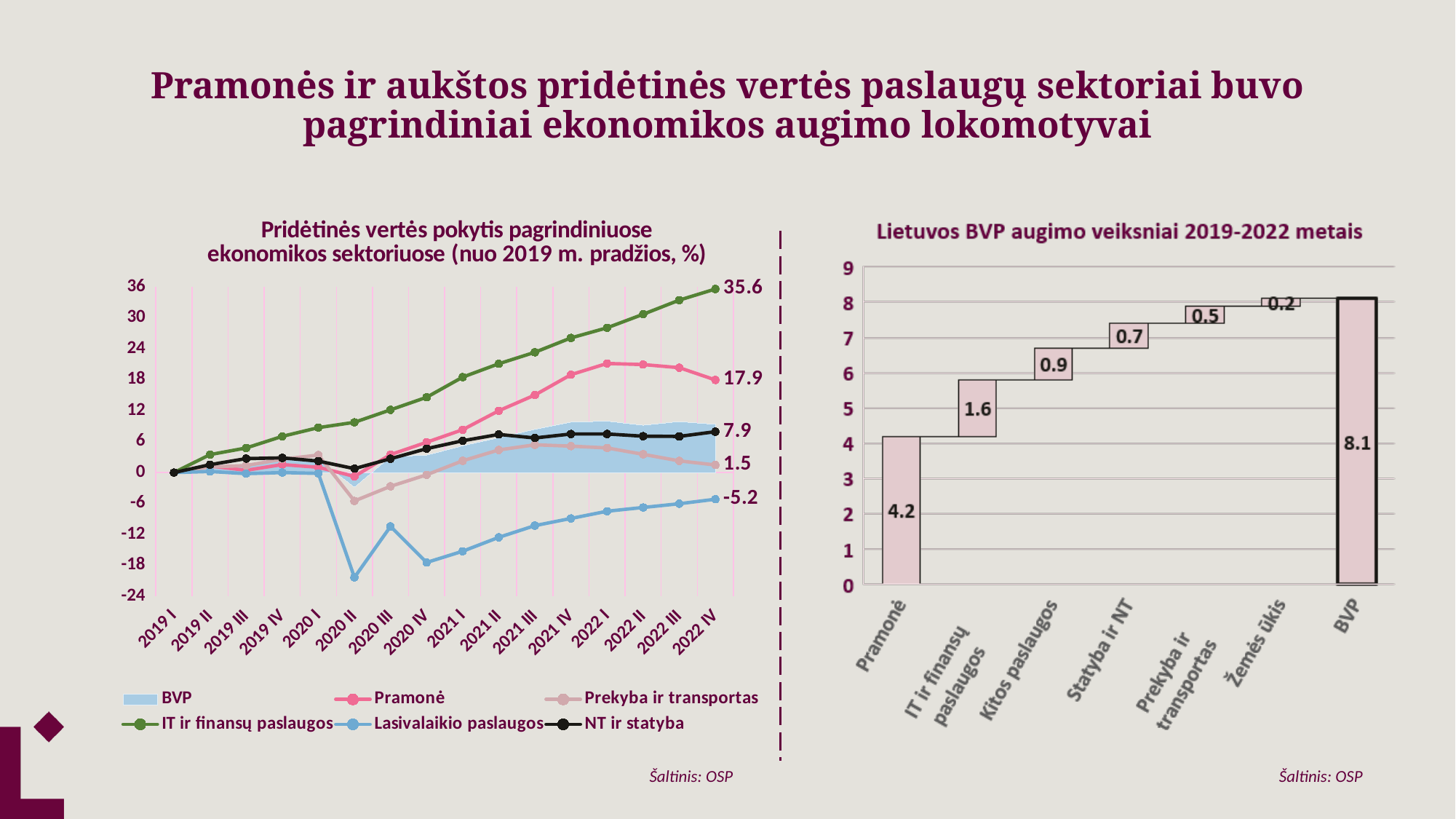
In the right chart 'Lietuvos BVP augimo veiksniai 2019-2022 metais', what is the value for BVP? 8.1 In the left chart 'Pridėtinės vertės pokytis pagrindiniuose ekonomikos sektoriuose', what is the difference between the 2022 IV values of IT ir finansų paslaugos and Pramonė? 17.7 In the left chart 'Pridėtinės vertės pokytis pagrindiniuose ekonomikos sektoriuose', does the IT ir finansų paslaugos line rise or fall from 2019 I to 2022 IV? rise In the left chart 'Pridėtinės vertės pokytis pagrindiniuose ekonomikos sektoriuose', what is the final value labelled for Laisvalaikio paslaugos at 2022 IV? -5.2 In the left chart 'Pridėtinės vertės pokytis pagrindiniuose ekonomikos sektoriuose', how many quarters are shown on the x axis? 16 In the left chart 'Pridėtinės vertės pokytis pagrindiniuose ekonomikos sektoriuose', what is the final value labelled for Pramonė at 2022 IV? 17.9 In the right chart 'Lietuvos BVP augimo veiksniai 2019-2022 metais', what is the value for IT ir finansų paslaugos? 1.6 In the right chart 'Lietuvos BVP augimo veiksniai 2019-2022 metais', what is the value for Pramonė? 4.2 In the left chart 'Pridėtinės vertės pokytis pagrindiniuose ekonomikos sektoriuose', how many series does the legend list? 6 In the left chart 'Pridėtinės vertės pokytis pagrindiniuose ekonomikos sektoriuose', what is the final value labelled for IT ir finansų paslaugos at 2022 IV? 35.6 In the left chart 'Pridėtinės vertės pokytis pagrindiniuose ekonomikos sektoriuose', which series has the highest value at 2022 IV? IT ir finansų paslaugos In the right chart 'Lietuvos BVP augimo veiksniai 2019-2022 metais', which contributing sector has the lowest value? Žemės ūkis